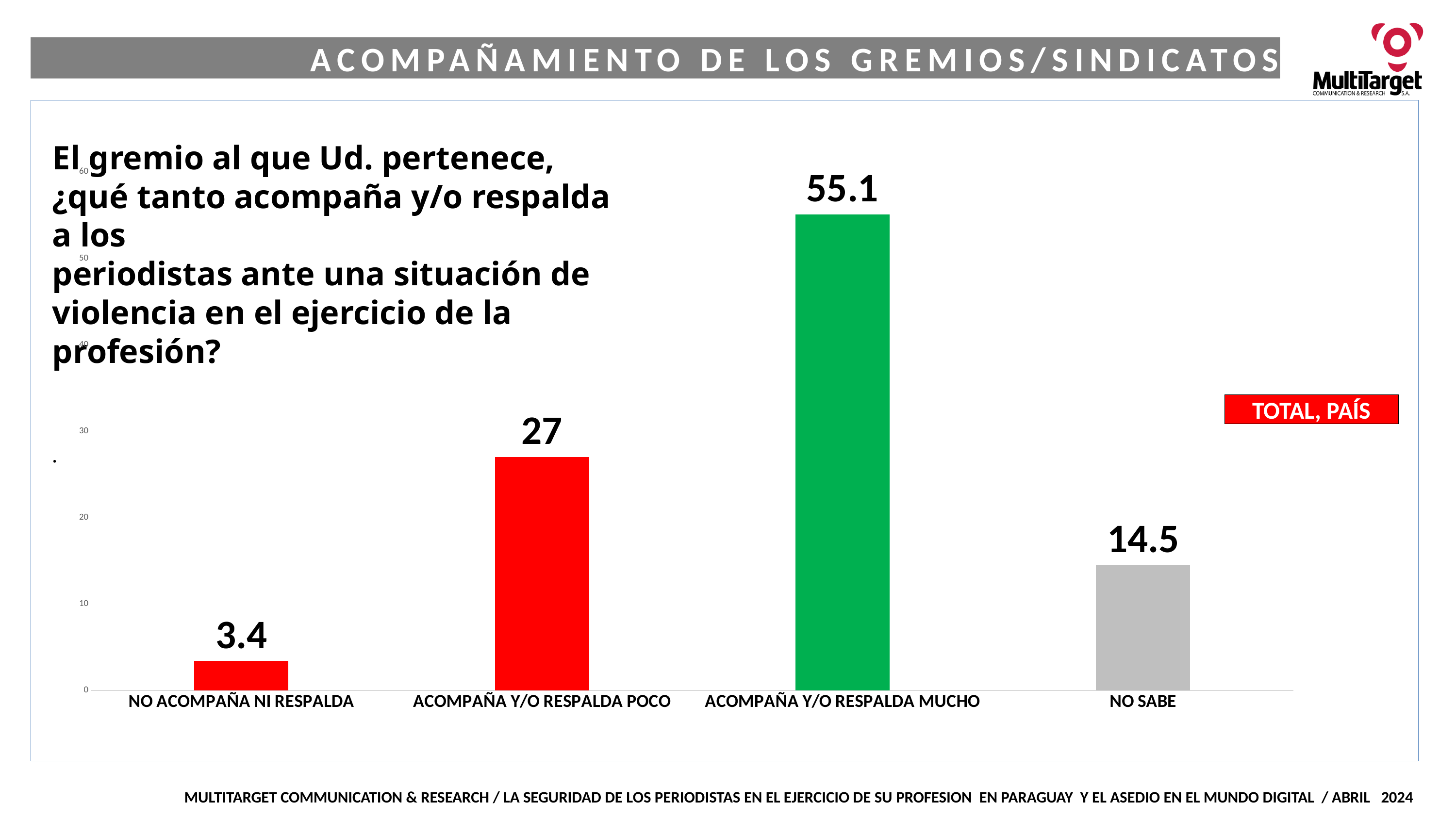
What kind of chart is shown on the slide? bar chart What is the value for ACOMPAÑA Y/O RESPALDA POCO? 27 Which category has the lowest value? NO ACOMPAÑA NI RESPALDA What is the value for NO ACOMPAÑA NI RESPALDA? 3.4 What is the difference between the values for ACOMPAÑA Y/O RESPALDA MUCHO and ACOMPAÑA Y/O RESPALDA POCO? 28.1 What is the value for ACOMPAÑA Y/O RESPALDA MUCHO? 55.1 What is the value for NO SABE? 14.5 How many categories are shown in the chart? 4 What colour is the bar for ACOMPAÑA Y/O RESPALDA MUCHO? green Which category has the highest value? ACOMPAÑA Y/O RESPALDA MUCHO Which is larger, the value for NO SABE or the value for NO ACOMPAÑA NI RESPALDA? NO SABE Is the value for ACOMPAÑA Y/O RESPALDA MUCHO greater or less than 50? greater